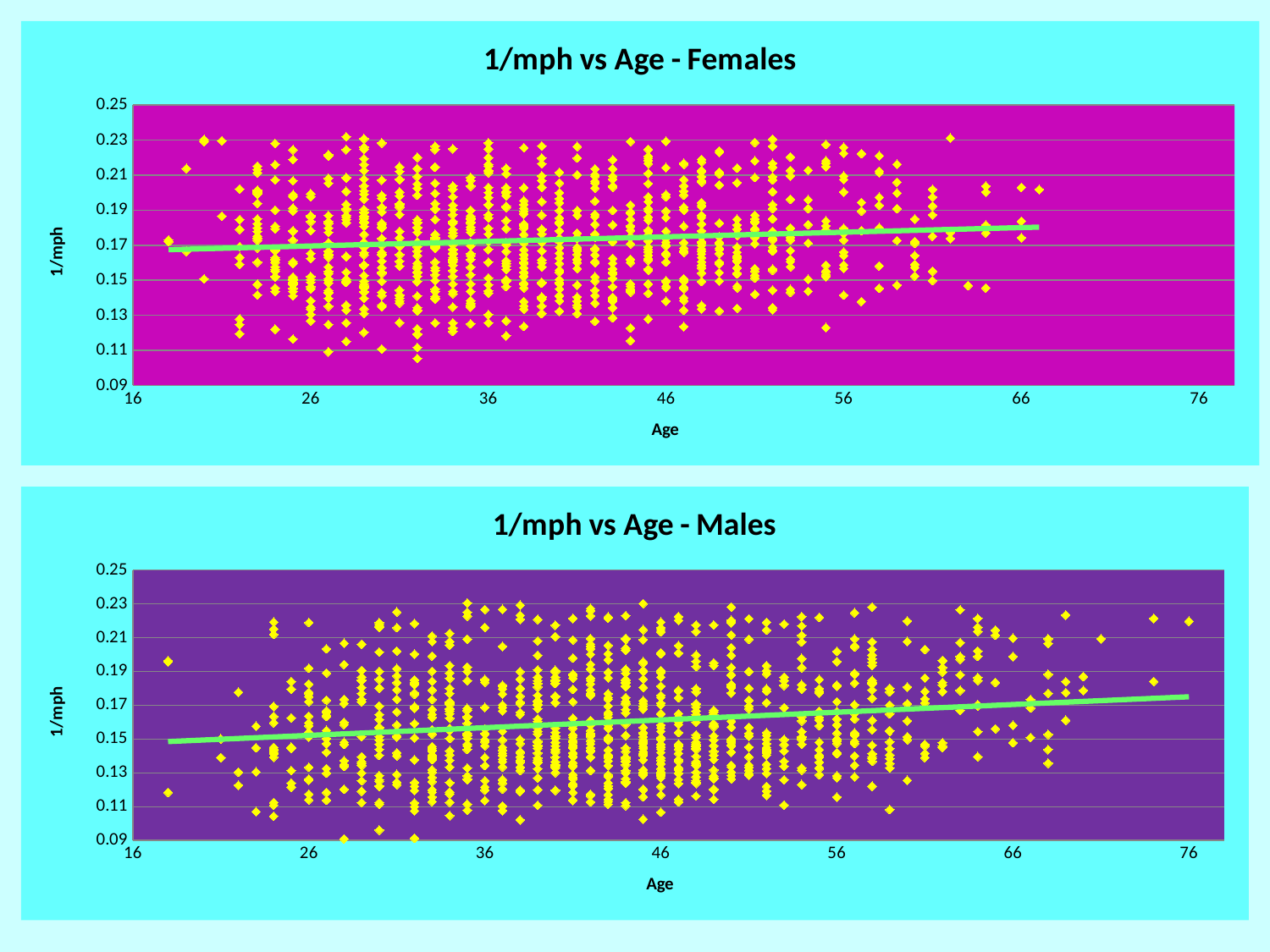
In the '1/mph vs Age - Males' chart, is the trend line value at age 26 greater or less than 0.17? less At age 26, which chart's trend line is higher, '1/mph vs Age - Females' or '1/mph vs Age - Males'? 1/mph vs Age - Females Which chart has the steeper trend line, '1/mph vs Age - Females' or '1/mph vs Age - Males'? 1/mph vs Age - Males What kind of chart is the '1/mph vs Age - Males' chart? scatter chart What is the title of the top chart on the slide? 1/mph vs Age - Females What is the label on the y axis of the '1/mph vs Age - Males' chart? 1/mph In the '1/mph vs Age - Males' chart, does the trend line rise or fall as age increases? rises In the '1/mph vs Age - Females' chart, does the trend line rise or fall as age increases? rises What kind of chart is the '1/mph vs Age - Females' chart? scatter chart In the '1/mph vs Age - Males' chart, is the trend line value at age 66 greater or less than 0.15? greater In the '1/mph vs Age - Females' chart, is the trend line value at age 16 greater or less than 0.19? less